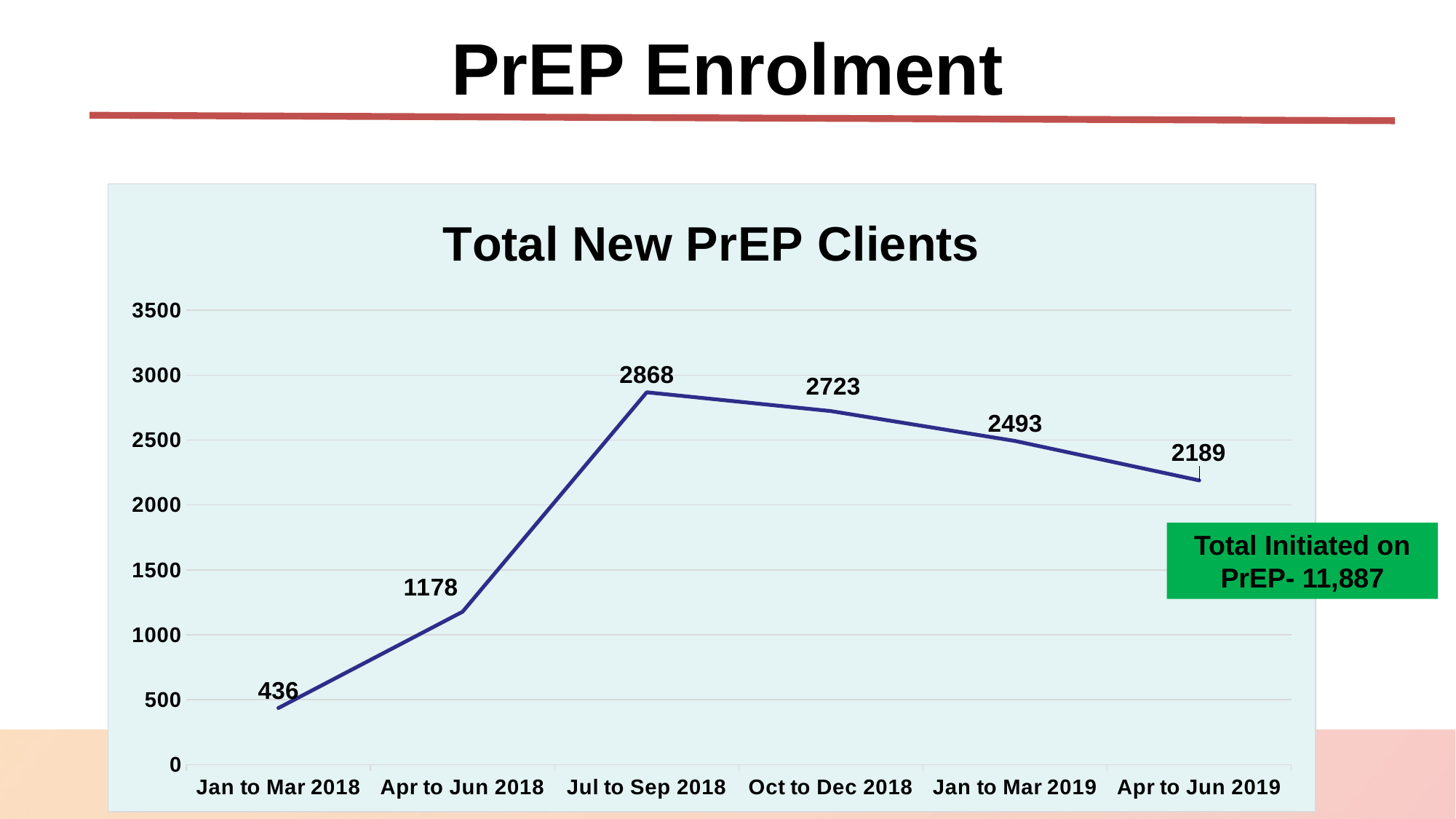
Is the value for Oct to Dec 2018 greater or less than 2500? greater What is the difference between the values for Jul to Sep 2018 and Oct to Dec 2018? 145 What is the value for Apr to Jun 2019? 2189 Which period has the highest number of new PrEP clients? Jul to Sep 2018 How many periods are plotted on the x axis? 6 What kind of chart is shown? line chart Which is larger, the value for Jan to Mar 2019 or the value for Apr to Jun 2019? Jan to Mar 2019 Which period has the lowest number of new PrEP clients? Jan to Mar 2018 What is the value for Jan to Mar 2018? 436 What is the value for Jul to Sep 2018? 2868 What is the title of the chart? Total New PrEP Clients What is the difference between the values for Apr to Jun 2018 and Jan to Mar 2018? 742